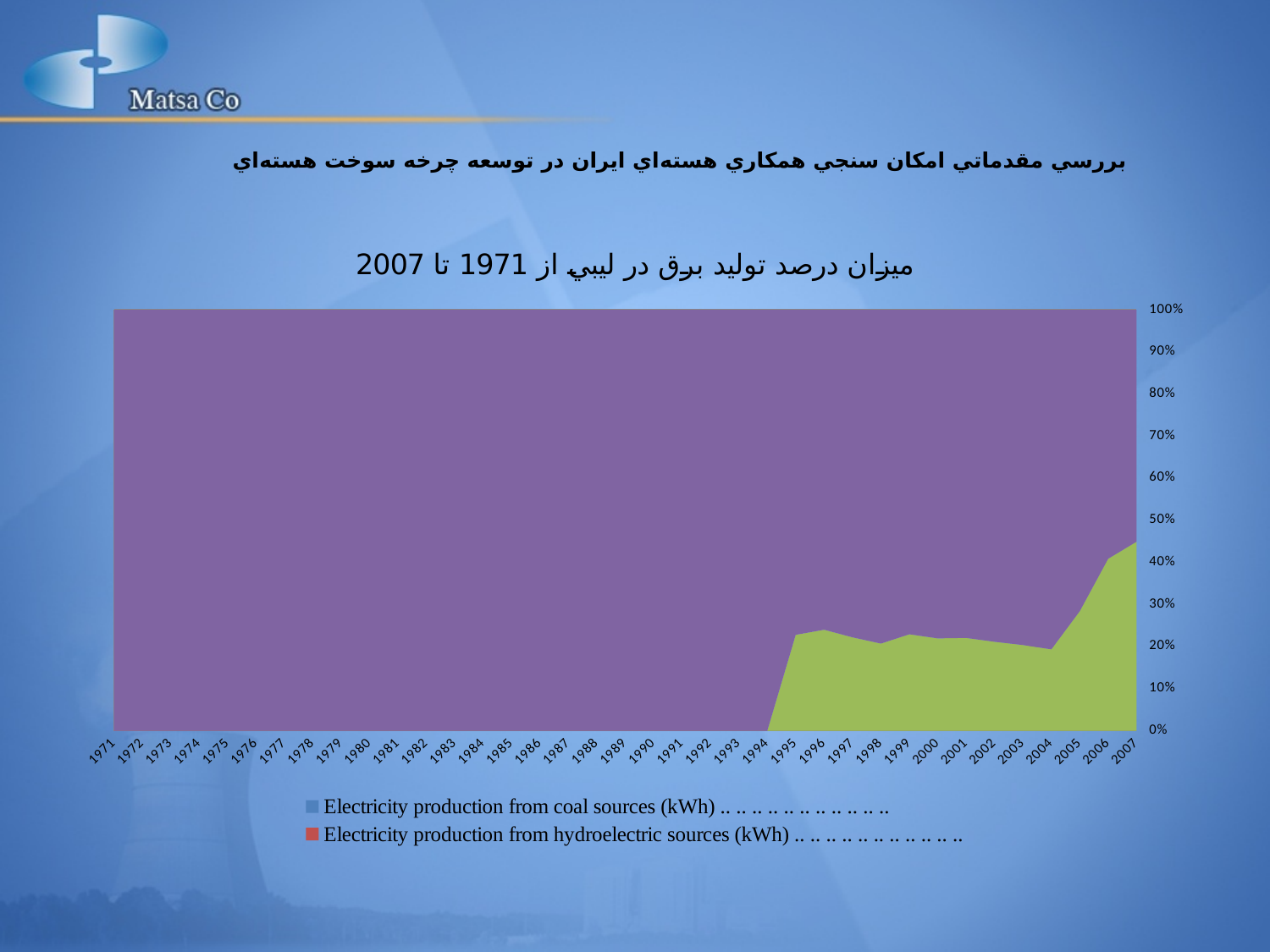
Is the value of the lower green area in 2007 greater or less than 40%? greater What is the value of the lower green area in 1985? 0% What is the last year shown on the x axis? 2007 Does the lower green area rise or fall from 2004 to 2007? rise How many series does the legend list? 2 How many years are shown along the x axis of the chart? 37 Is the value of the lower green area in 1996 greater or less than 20%? greater Is the value of the lower green area in 2004 greater or less than 30%? less What is the highest value shown on the y axis? 100% What kind of chart is shown on the slide? area chart What is the first year shown on the x axis? 1971 Which is larger in 2007, the upper purple area or the lower green area? the upper purple area